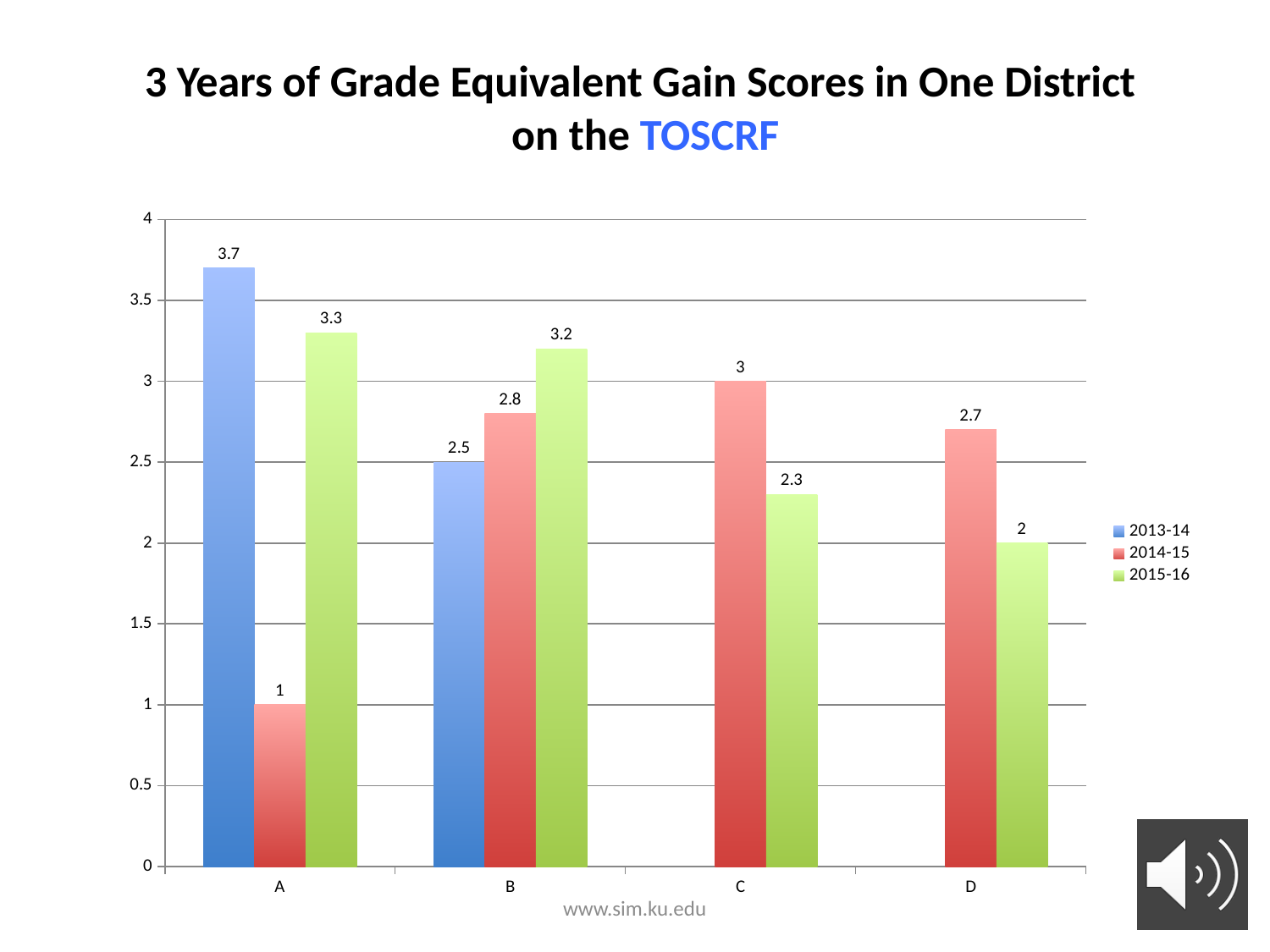
Do the 2015-16 values rise or fall from category A to category D? Fall Which is larger, the 2014-15 value for B or the 2015-16 value for B? 2015-16 What is the 2014-15 value for category C? 3 How many categories are shown on the x axis? 4 What is the 2015-16 value for category D? 2 What is the 2013-14 value for category A? 3.7 What is the difference between the 2015-16 value for A and the 2014-15 value for A? 2.3 What kind of chart is shown on the slide? Bar chart Which categories have no 2013-14 bar? C and D Which category has the lowest 2015-16 value? D How many series does the legend list? 3 Which category has the highest 2014-15 value? C